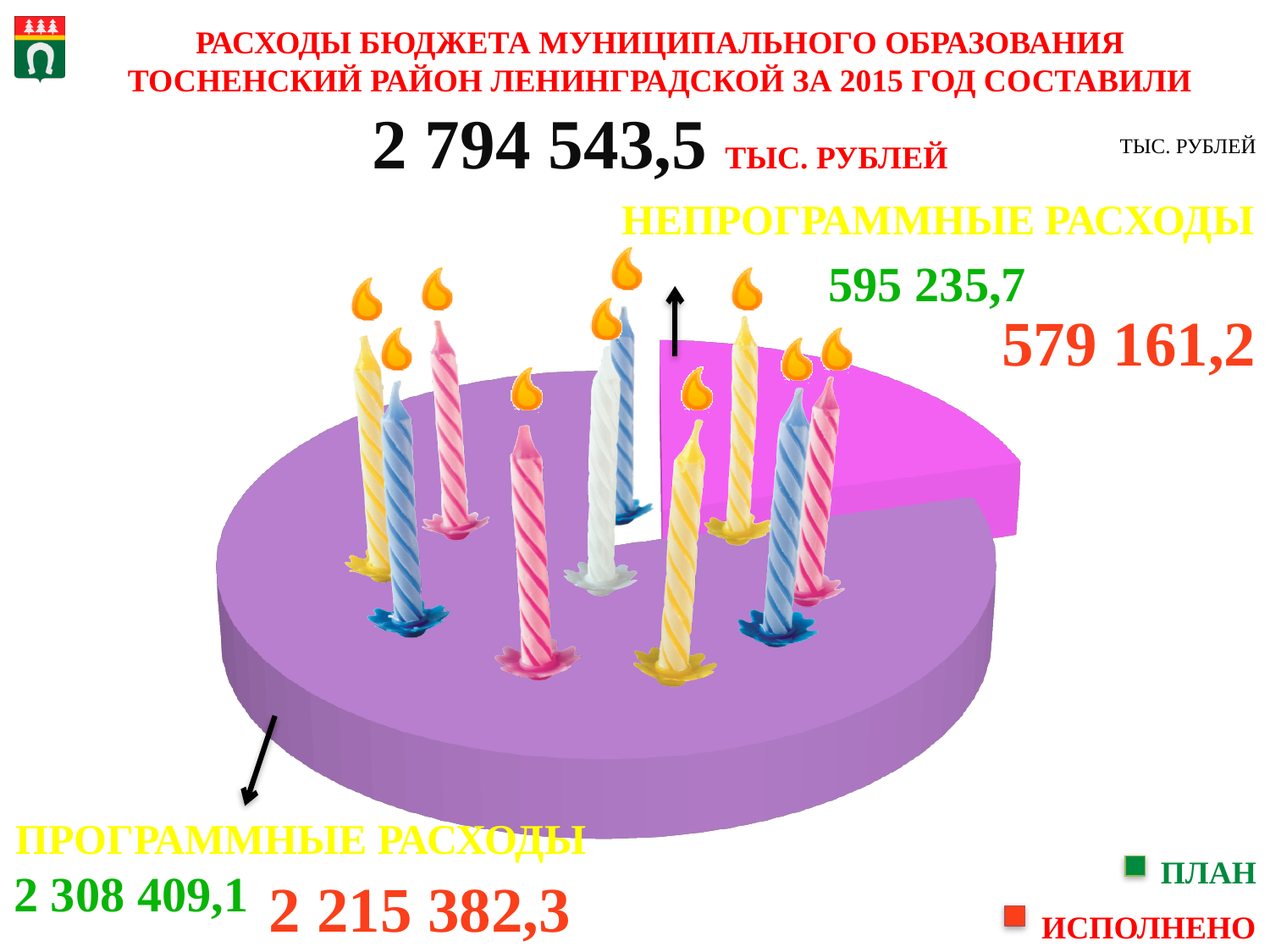
What kind of chart is shown on the slide? pie chart Which category has the smaller slice of the pie? НЕПРОГРАММНЫЕ РАСХОДЫ What is the executed (ИСПОЛНЕНО) value for НЕПРОГРАММНЫЕ РАСХОДЫ? 579 161,2 What are the two legend entries? ПЛАН, ИСПОЛНЕНО How many slices does the pie chart have? 2 Which category has the larger slice of the pie? ПРОГРАММНЫЕ РАСХОДЫ What is the difference between the planned and executed values for ПРОГРАММНЫЕ РАСХОДЫ? 93 026,8 What is the planned (ПЛАН) value for НЕПРОГРАММНЫЕ РАСХОДЫ? 595 235,7 What is the difference between the planned and executed values for НЕПРОГРАММНЫЕ РАСХОДЫ? 16 074,5 What is the planned (ПЛАН) value for ПРОГРАММНЫЕ РАСХОДЫ? 2 308 409,1 What is the executed (ИСПОЛНЕНО) value for ПРОГРАММНЫЕ РАСХОДЫ? 2 215 382,3 How many series does the legend list? 2